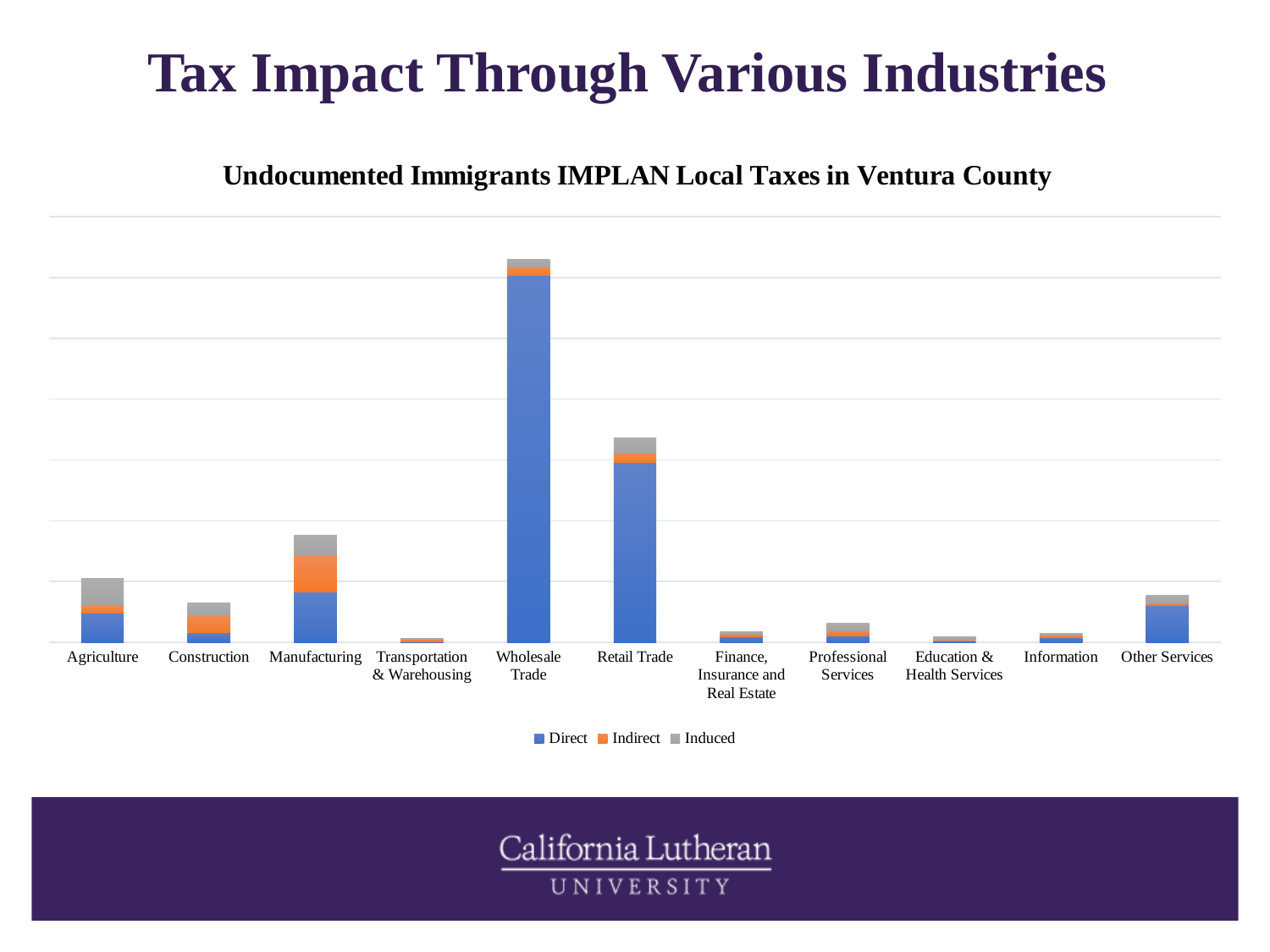
How many series does the legend list? 3 Which industry has the lowest total local taxes? Transportation & Warehousing How many industry categories are shown on the x axis? 11 Which has a larger total bar, Retail Trade or Manufacturing? Retail Trade Which has a larger total bar, Manufacturing or Agriculture? Manufacturing Which has a larger total bar, Agriculture or Construction? Agriculture Which industry has the second highest total bar? Retail Trade Which series are listed in the legend? Direct, Indirect, Induced What is the title of the chart? Undocumented Immigrants IMPLAN Local Taxes in Ventura County What type of chart is shown on the slide? Stacked bar chart Which industry has the highest total local taxes? Wholesale Trade